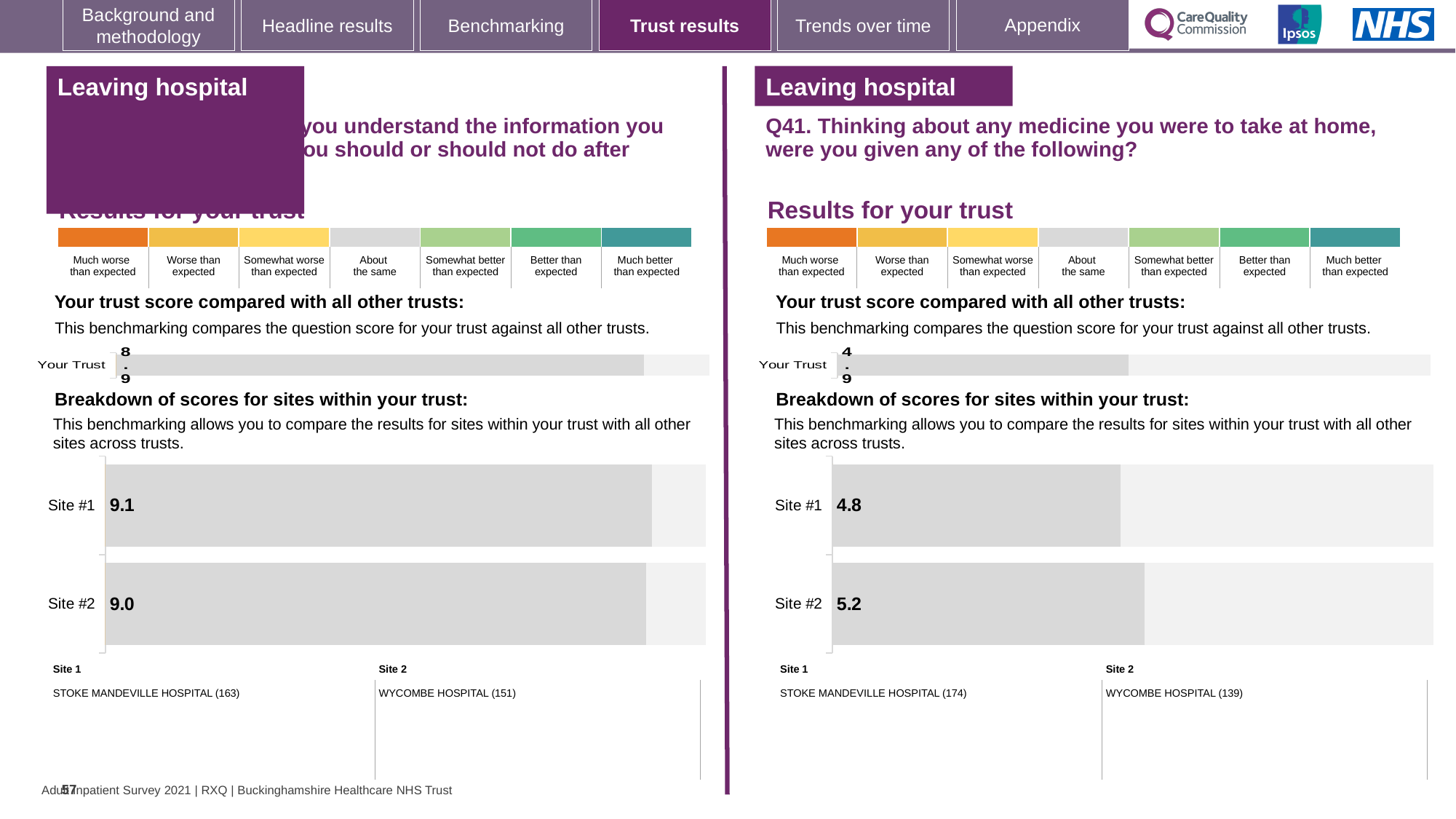
On the right-hand (Q41) site breakdown chart, what is the score for Site #1? 4.8 On the left-hand site breakdown chart, what is the score for Site #2? 9.0 On the right-hand (Q41) side, which hospital is listed as Site 2? WYCOMBE HOSPITAL (139) On the right-hand (Q41) site breakdown chart, what is the score for Site #2? 5.2 On the left-hand site breakdown chart, what is the difference between the Site #1 and Site #2 scores? 0.1 On the left-hand 'Your Trust' chart, what is the trust score shown? 8.9 On the left-hand site breakdown chart, how many sites are plotted? 2 What type of chart is used for the site breakdown on the right-hand (Q41) side of the slide? Bar chart On the right-hand (Q41) site breakdown chart, what is the difference between the Site #2 and Site #1 scores? 0.4 On the right-hand (Q41) 'Your Trust' chart, what is the trust score shown? 4.9 On the left-hand site breakdown chart, what is the score for Site #1? 9.1 On the right-hand (Q41) site breakdown chart, which site has the higher score? Site #2